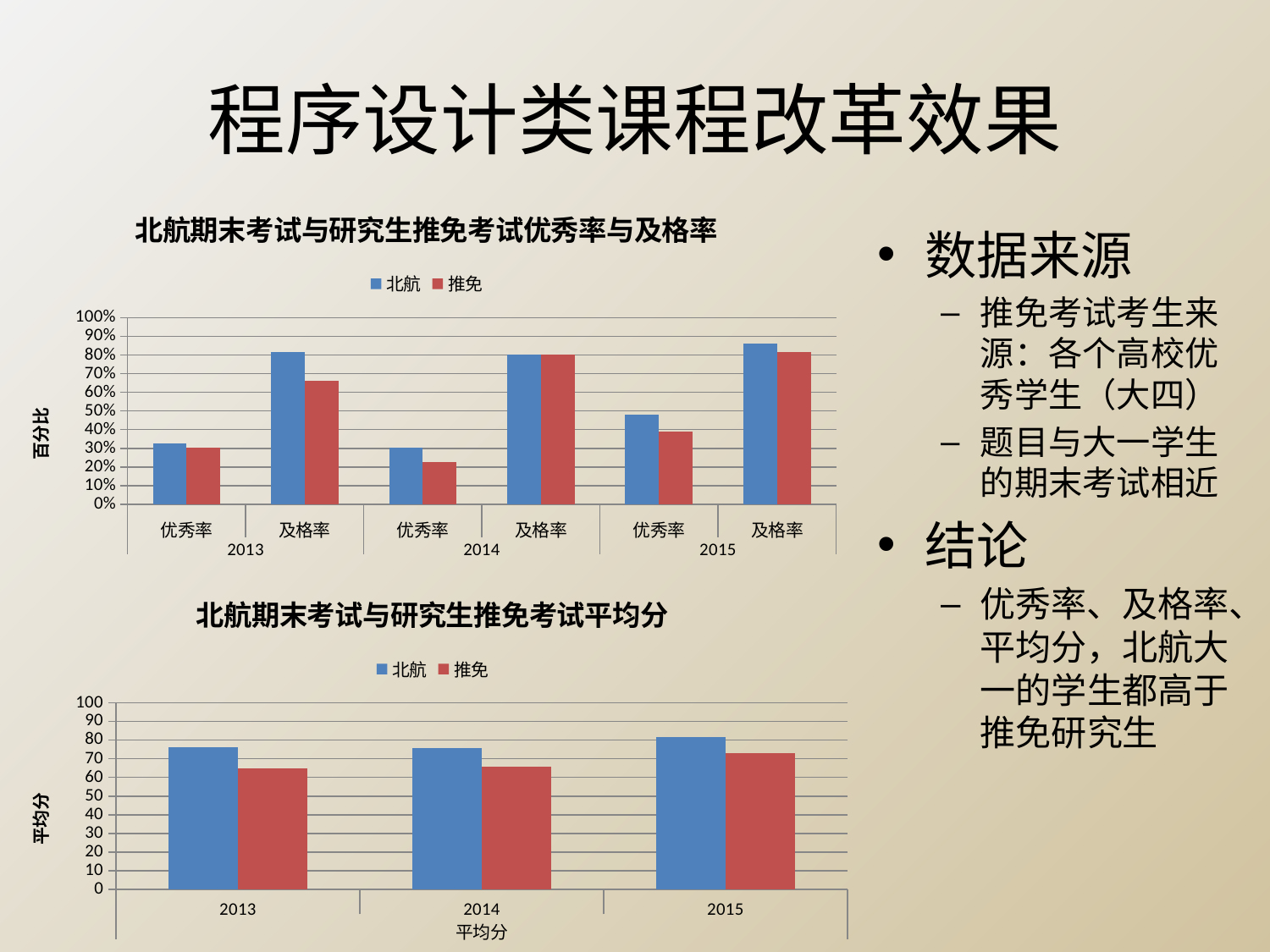
In the bottom chart (平均分), is the 推免 value for 2013 greater or less than 70? less In the bottom chart (平均分), how many year categories are shown on the x axis? 3 In the top chart (优秀率与及格率), is the 推免 value for 优秀率 in 2014 greater or less than 30%? less In the bottom chart (平均分), which year has the highest 北航 value? 2015 How many series does the legend of the bottom chart (北航期末考试与研究生推免考试平均分) list? 2 What kind of chart is the top chart titled 北航期末考试与研究生推免考试优秀率与及格率? bar chart In the top chart (优秀率与及格率), which series has the larger 及格率 in 2013, 北航 or 推免? 北航 In the top chart (优秀率与及格率), is the 北航 value for 优秀率 in 2015 greater or less than 40%? greater What are the two legend entries of the top chart (优秀率与及格率)? 北航 and 推免